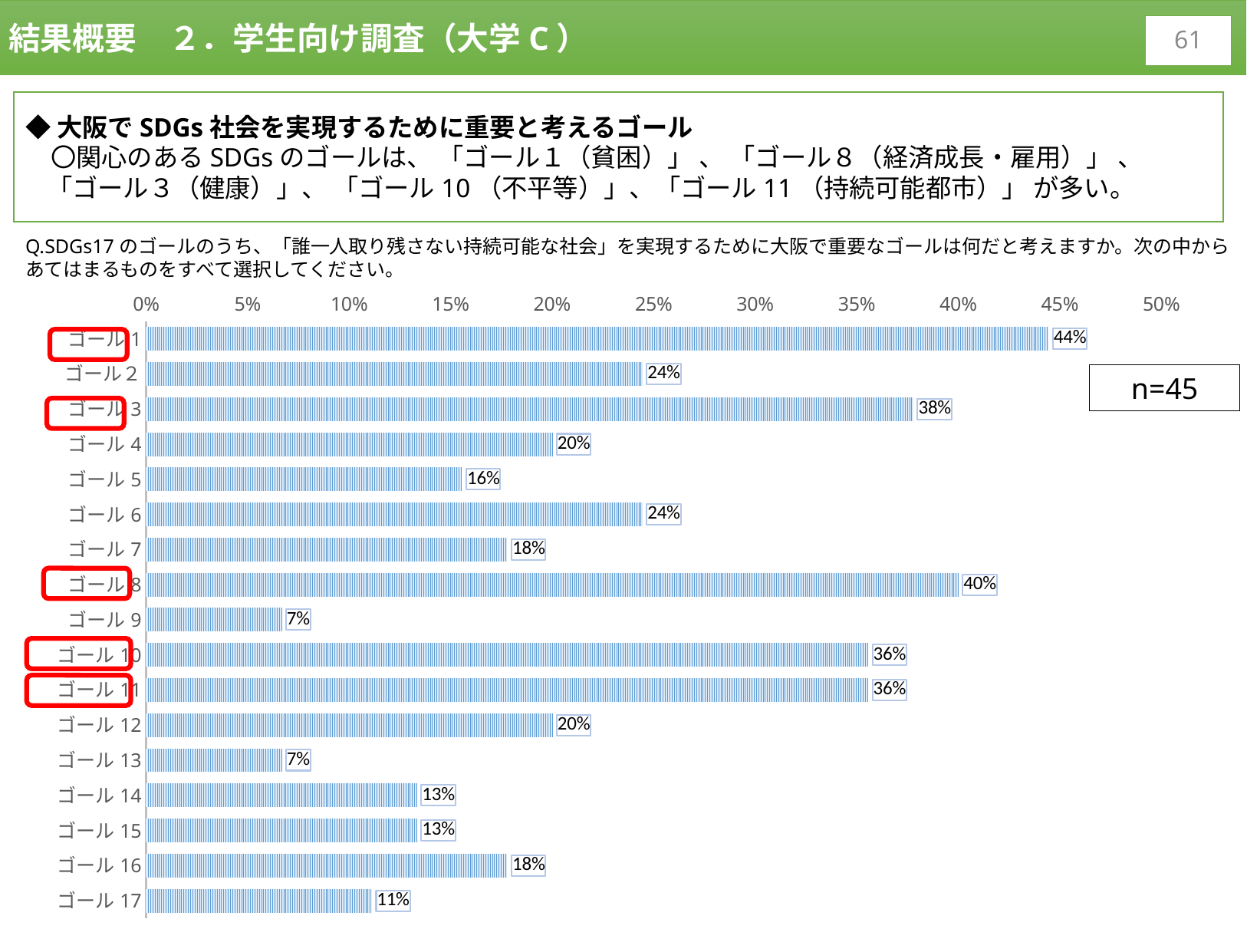
What is the value for ゴール 1? 44% Which is larger, the value for ゴール 8 or the value for ゴール 10? ゴール 8 What is the maximum value shown on the horizontal axis? 50% What is the difference between the values for ゴール 10 and ゴール 9? 29% What is the sample size (n) shown on the slide? n=45 What is the value for ゴール 8? 40% What kind of chart is shown on the slide? bar chart Is the value for ゴール 6 greater or less than 20%? greater What is the difference between the values for ゴール 1 and ゴール 3? 6% How many goals (categories) are shown in the chart? 17 Which goal has the highest value? ゴール 1 What is the value for ゴール 17? 11%